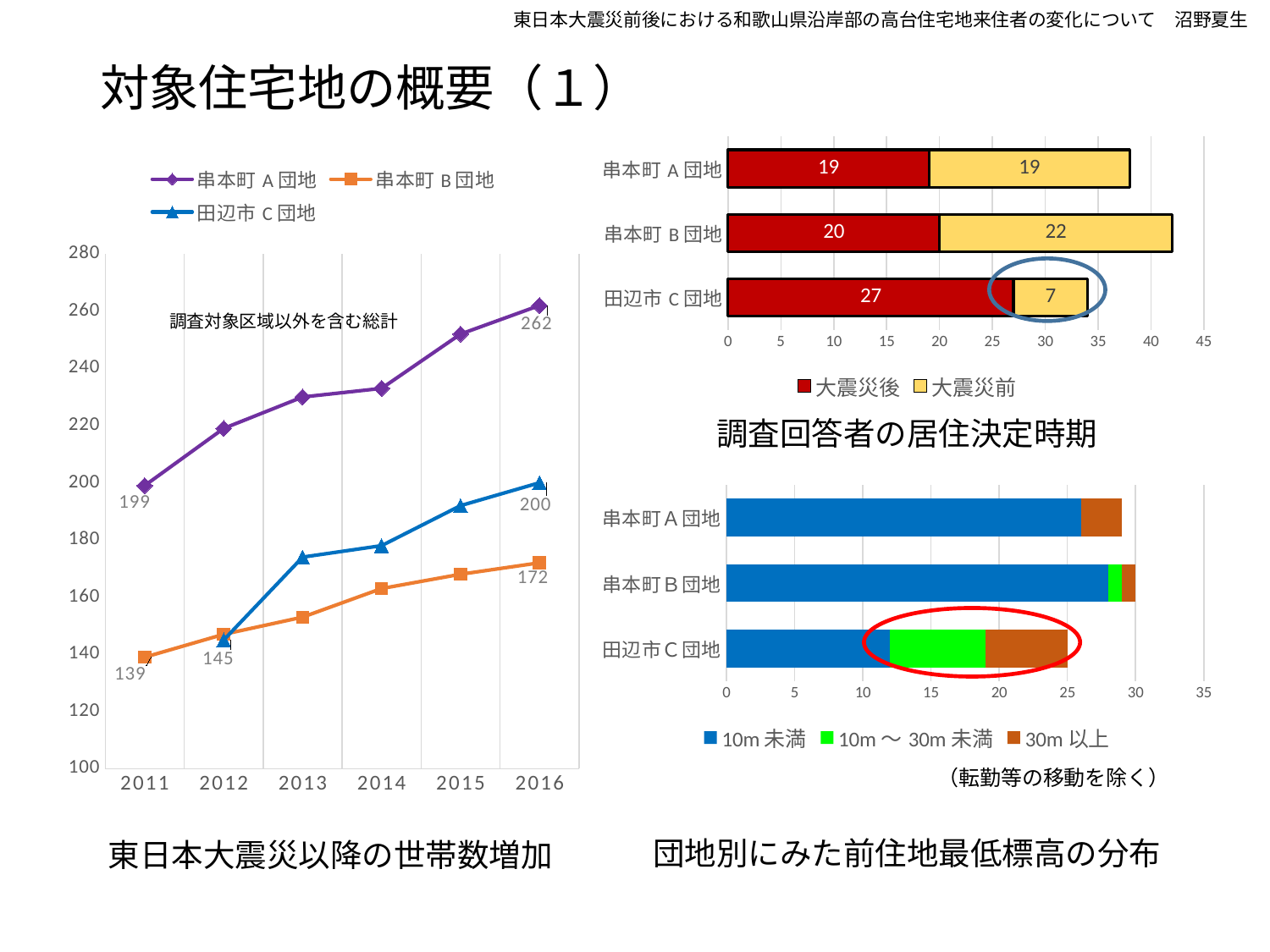
In the chart titled 団地別にみた前住地最低標高の分布, is the 10m未満 value for 田辺市C団地 greater or less than 10? greater In the chart titled 東日本大震災以降の世帯数増加, what kind of chart is it? line chart In the chart titled 東日本大震災以降の世帯数増加, what is the value for 田辺市C団地 in 2012? 145 In the chart titled 調査回答者の居住決定時期, which category has the lowest 大震災前 value? 田辺市C団地 In the chart titled 東日本大震災以降の世帯数増加, what is the value for 串本町B団地 in 2011? 139 In the chart titled 調査回答者の居住決定時期, what is the total of the stacked bar for 串本町B団地? 42 In the chart titled 団地別にみた前住地最低標高の分布, how many series does the legend list? 3 In the chart titled 東日本大震災以降の世帯数増加, how many series does the legend list? 3 In the chart titled 調査回答者の居住決定時期, what is the 大震災後 value for 田辺市C団地? 27 In the chart titled 東日本大震災以降の世帯数増加, does the 串本町B団地 series rise or fall from 2011 to 2016? rise In the chart titled 東日本大震災以降の世帯数増加, what is the value for 串本町A団地 in 2016? 262 In the chart titled 東日本大震災以降の世帯数増加, by how much did 串本町A団地 increase from 2011 to 2016? 63